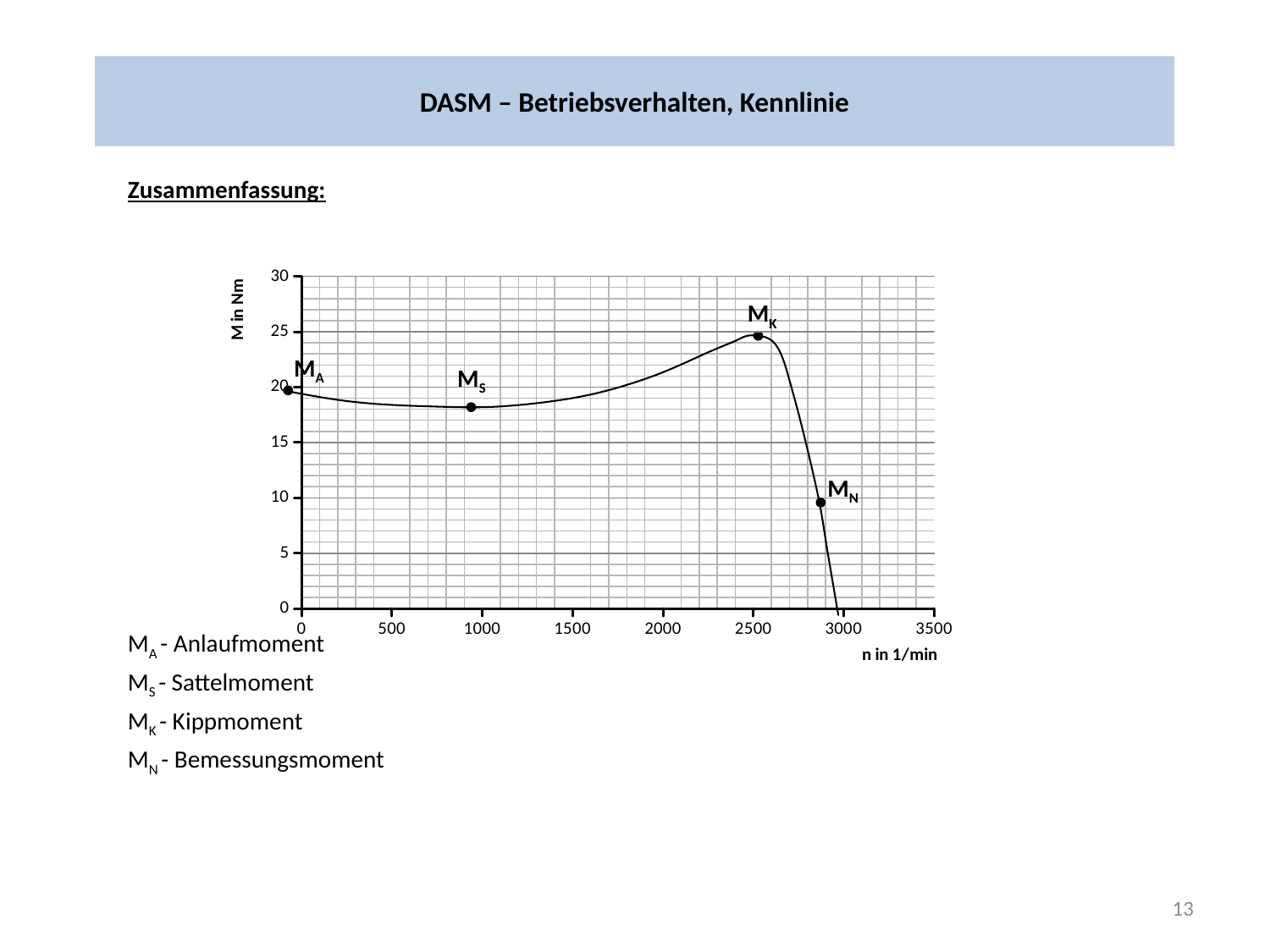
What is the label of the vertical axis? M in Nm Is the torque value at M_N greater or less than 15 Nm? less Is the torque value at M_S greater or less than 20 Nm? less Which is larger, the torque at M_A or the torque at M_S? M_A Which of the marked points on the curve has the highest torque value? M_K How many labelled points are marked on the curve? 4 Is the torque value at M_K greater or less than 20 Nm? greater What kind of chart is shown on the slide? line chart Which is larger, the torque at M_K or the torque at M_N? M_K Does the curve rise or fall between M_S and M_K as n increases? rises Which of the marked points on the curve has the lowest torque value? M_N